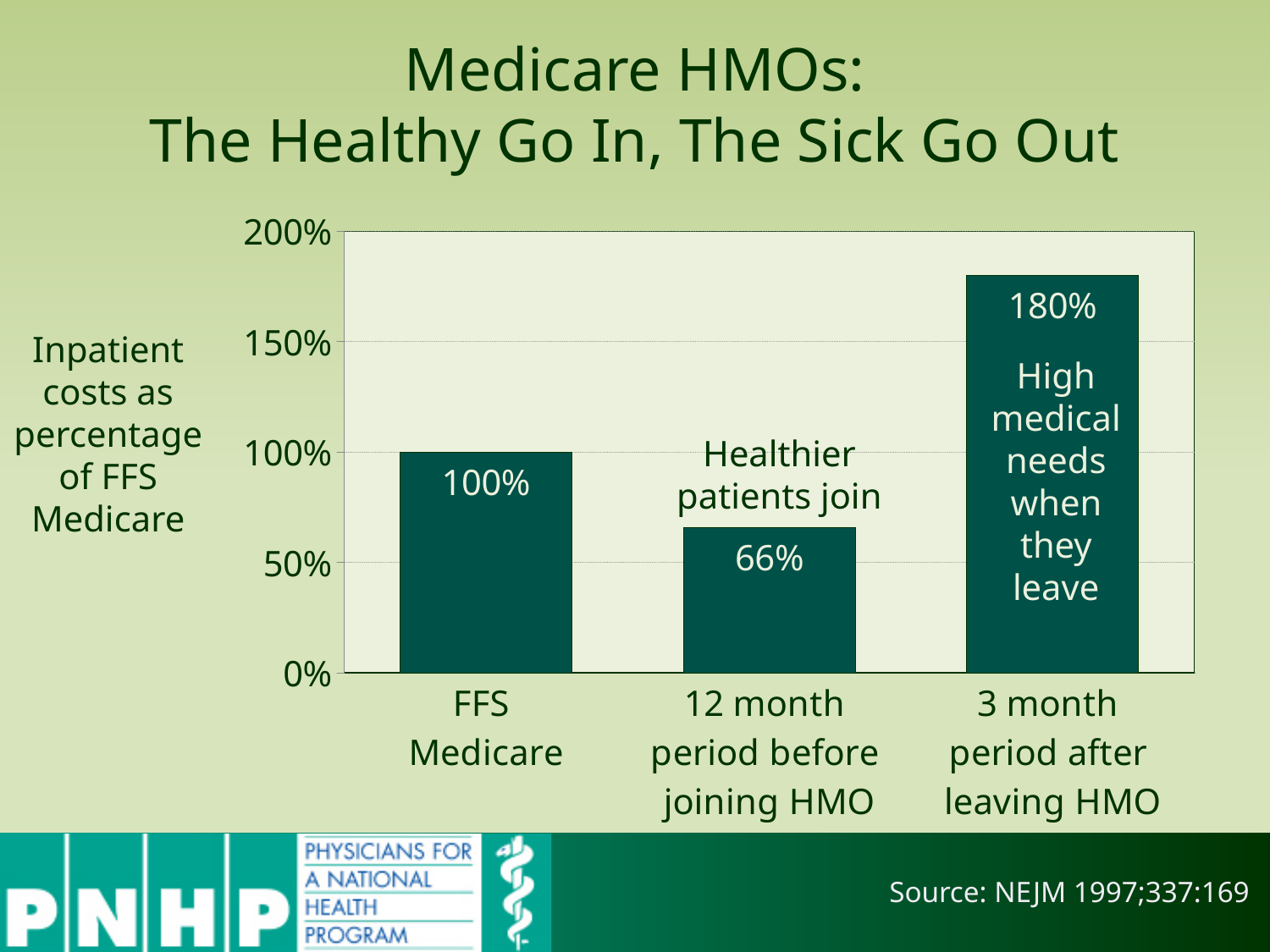
Which is larger: the value for the 12 month period before joining HMO or the value for the 3 month period after leaving HMO? 3 month period after leaving HMO What is the value for FFS Medicare? 100% What is the difference between the value for the 3 month period after leaving HMO and the value for FFS Medicare? 80% What is the title of the slide containing the chart? Medicare HMOs: The Healthy Go In, The Sick Go Out What kind of chart is shown on the slide? Bar chart What is the difference between the value for FFS Medicare and the value for the 12 month period before joining HMO? 34% What is the value for the 12 month period before joining HMO? 66% What is the value for the 3 month period after leaving HMO? 180% How many categories are shown on the chart? 3 Which category has the highest value? 3 month period after leaving HMO Which category has the lowest value? 12 month period before joining HMO Is the value for the 3 month period after leaving HMO greater or less than 150%? greater